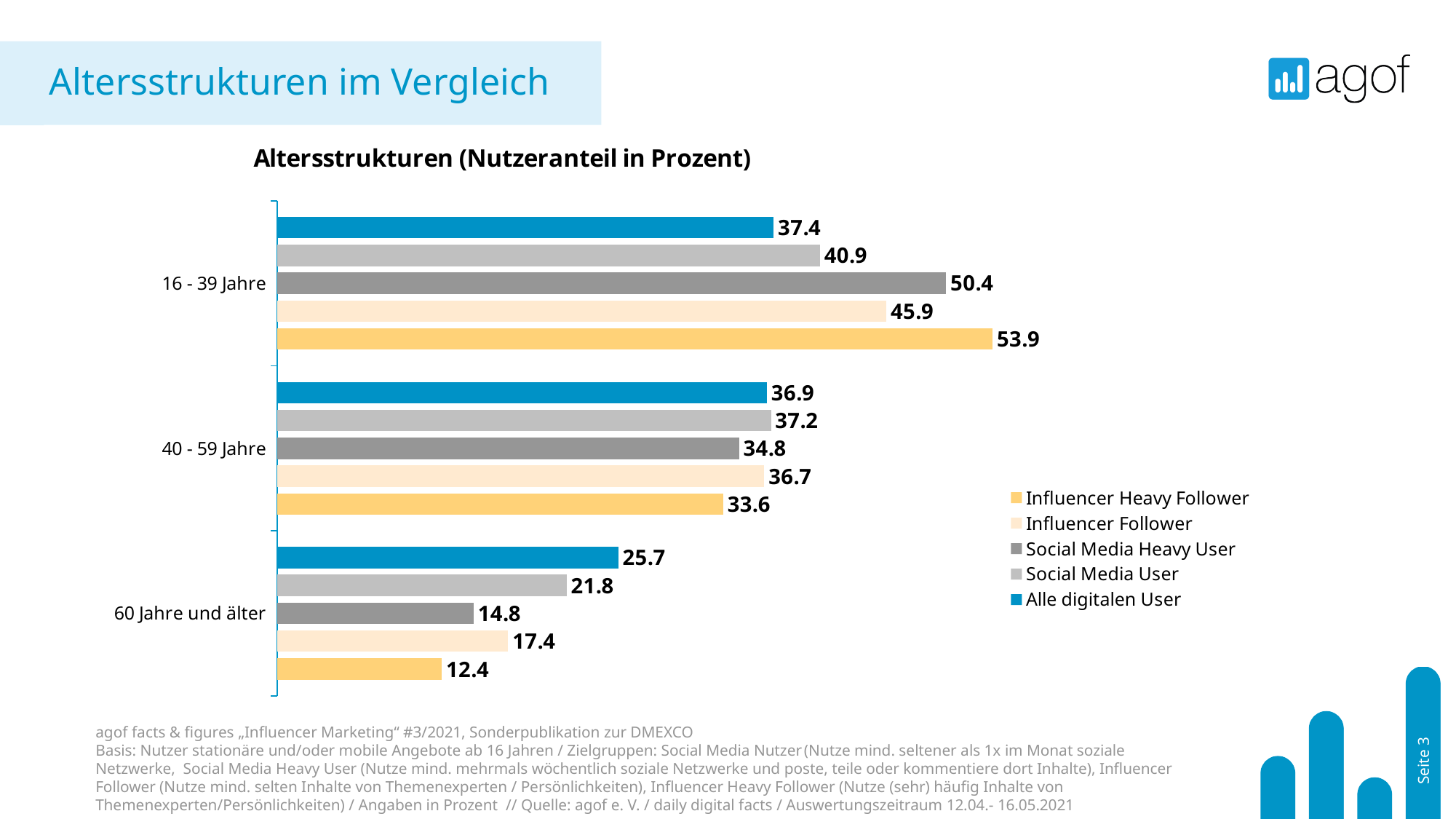
What is the difference between Influencer Heavy Follower in the 16 - 39 Jahre group and in the 60 Jahre und älter group? 41.5 How many series does the legend list? 5 Which series has the lowest value in the 60 Jahre und älter group? Influencer Heavy Follower What is the value for Social Media Heavy User in the 40 - 59 Jahre group? 34.8 What is the value for Alle digitalen User in the 60 Jahre und älter group? 25.7 Which is larger in the 60 Jahre und älter group: Influencer Follower or Social Media Heavy User? Influencer Follower How many age groups are shown on the chart? 3 Which series has the highest value in the 16 - 39 Jahre group? Influencer Heavy Follower What kind of chart is shown on the slide? Bar chart What is the difference between Social Media Heavy User and Social Media User in the 16 - 39 Jahre group? 9.5 What is the title of the chart? Altersstrukturen (Nutzeranteil in Prozent) What is the value for Influencer Heavy Follower in the 16 - 39 Jahre group? 53.9